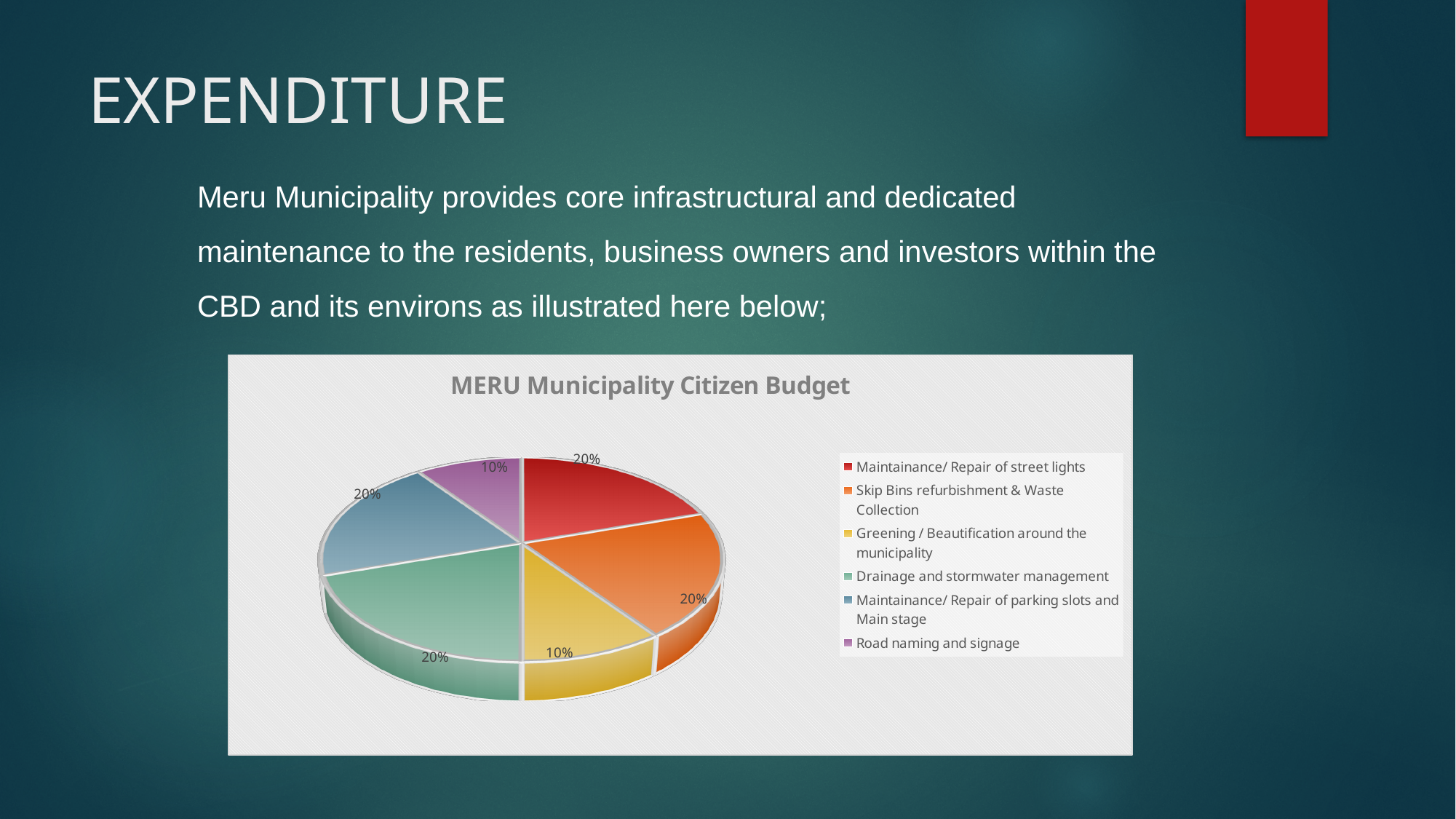
What is the difference between the share for Drainage and stormwater management and the share for Greening / Beautification around the municipality? 10% What share of the pie is Greening / Beautification around the municipality? 10% What share of the pie is Skip Bins refurbishment & Waste Collection? 20% What share of the pie is Road naming and signage? 10% What is the title of the chart? MERU Municipality Citizen Budget What kind of chart is shown on the slide? pie chart Which colour represents Road naming and signage in the pie chart? purple How many categories does the legend of the pie chart list? 6 Which is larger: the share for Maintainance/ Repair of street lights or the share for Road naming and signage? Maintainance/ Repair of street lights